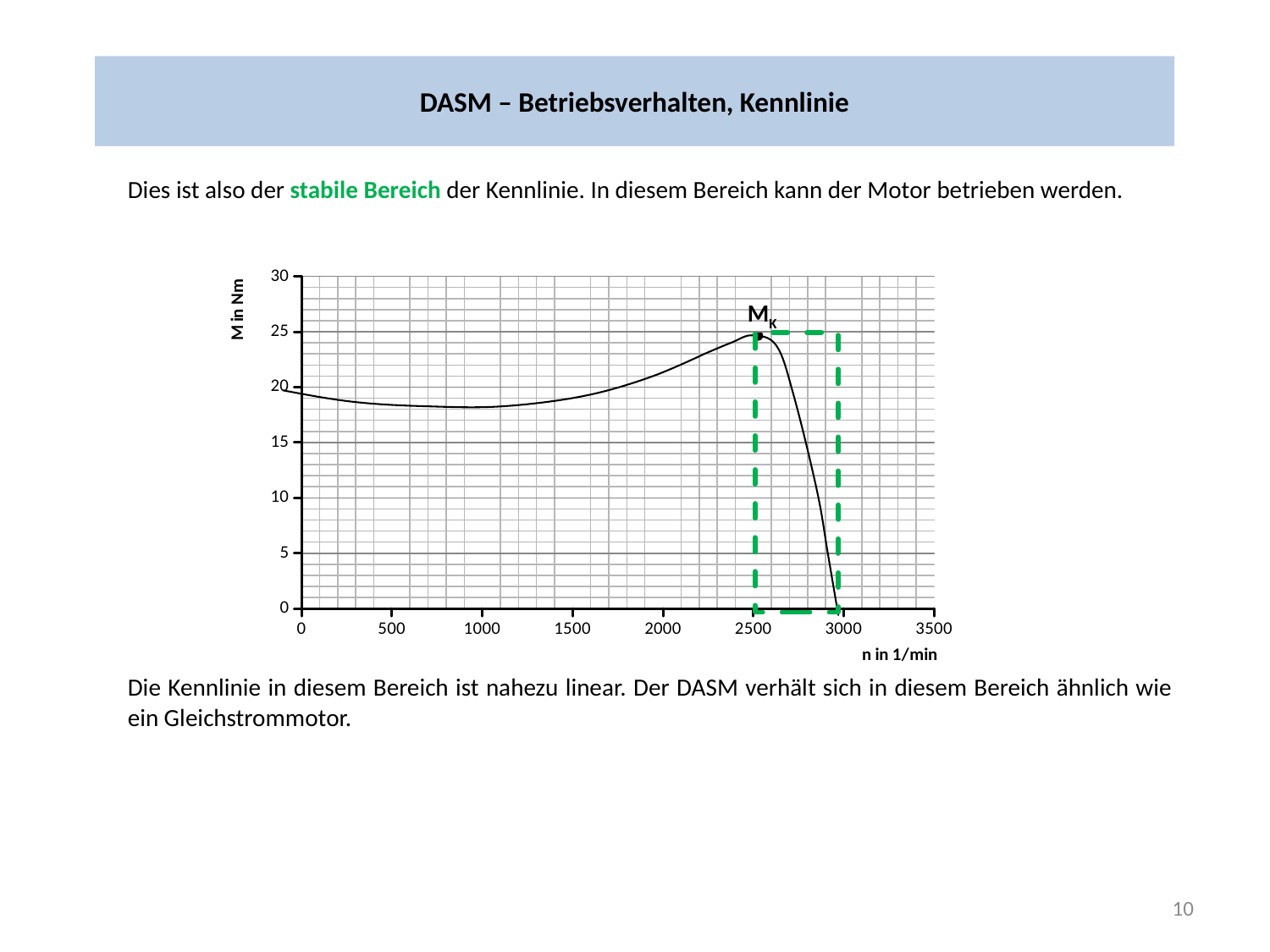
Is the value of M at n = 1000 greater or less than 20? less What kind of chart is shown on the slide? line chart What is the label of the vertical axis of the chart? M in Nm What is the label of the horizontal axis of the chart? n in 1/min Does the curve rise or fall between n = 1500 and n = 2500? rise What is the highest tick value shown on the horizontal axis? 3500 Is the value of M at n = 2900 greater or less than 10? less Does the curve rise or fall between n = 2500 and n = 3000? fall Is the value of M at n = 2500 greater or less than 20? greater Which is larger, the value of M at n = 2500 or at n = 2900? n = 2500